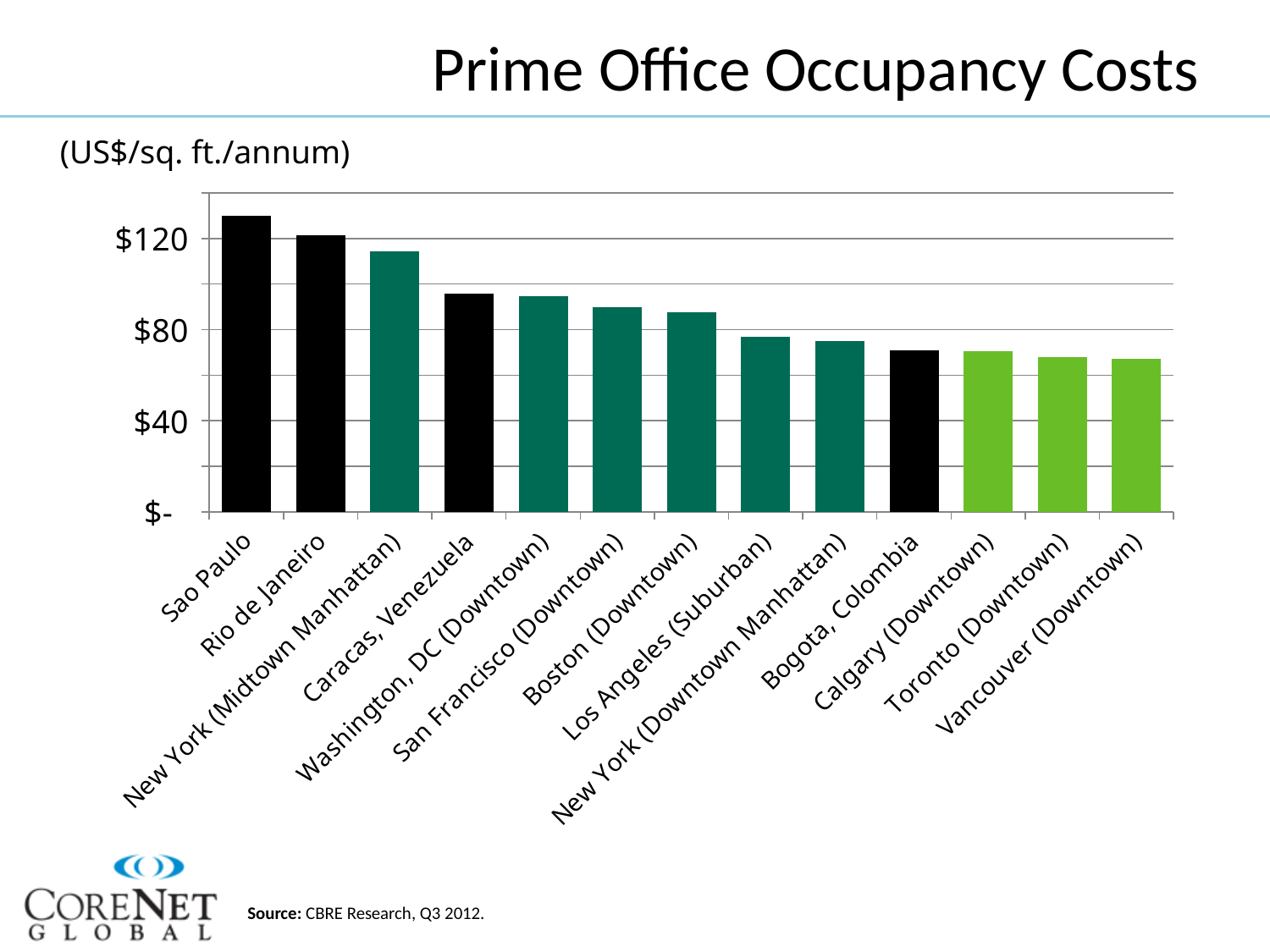
Is the value for Sao Paulo greater or less than $120? greater Is the value for Los Angeles (Suburban) greater or less than $80? less How many cities or markets are plotted in the chart? 13 Is the value for Caracas, Venezuela greater or less than $80? greater Which is larger, the value for New York (Midtown Manhattan) or New York (Downtown Manhattan)? New York (Midtown Manhattan) Do the values rise or fall moving from left to right along the x axis? Fall What kind of chart is shown on the slide? Bar chart Which is larger, the value for Caracas, Venezuela or Boston (Downtown)? Caracas, Venezuela What unit is the chart measured in, according to the slide? US$/sq. ft./annum Which market has the highest prime office occupancy cost? Sao Paulo